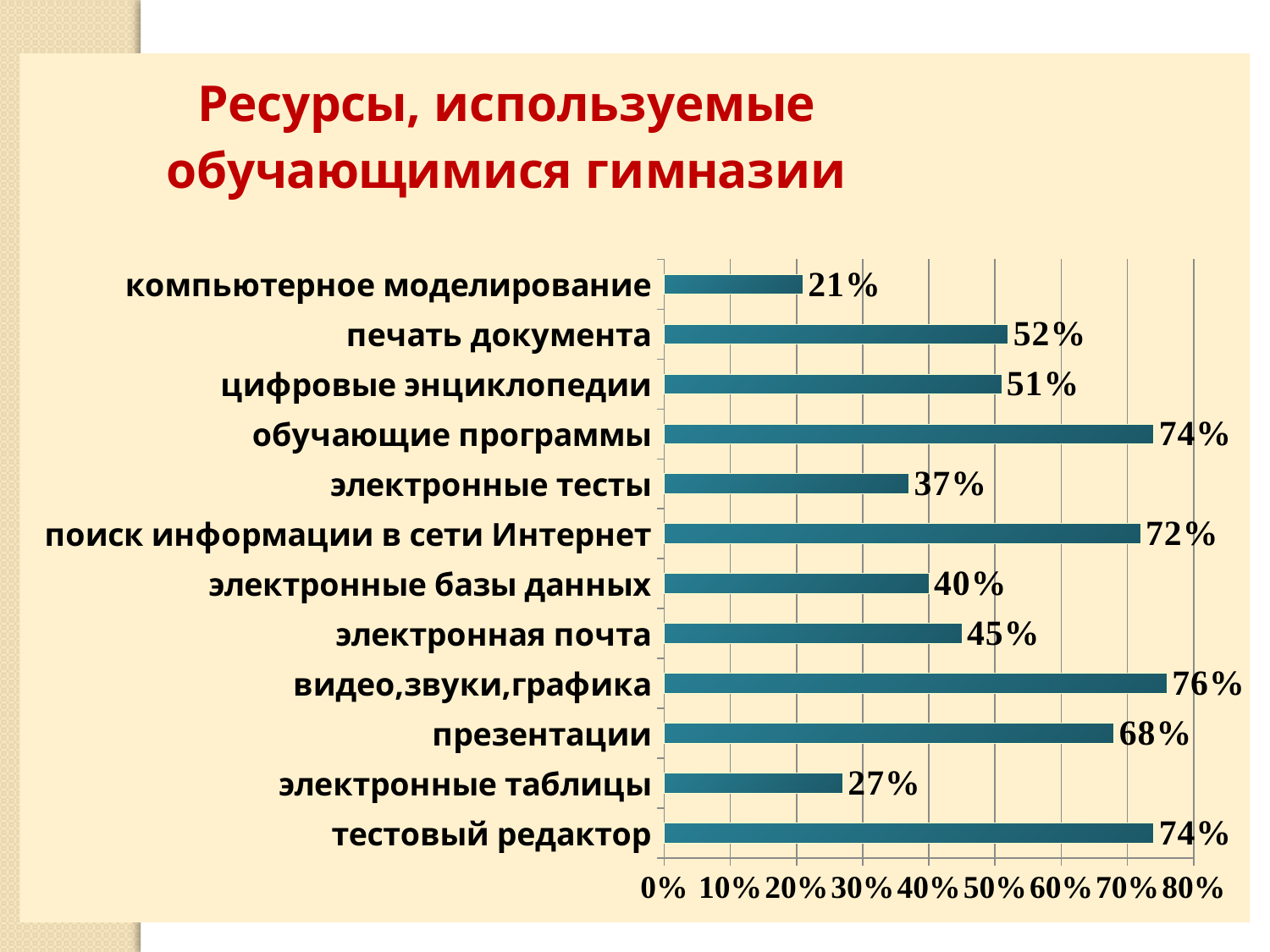
Is the value for печать документа greater or less than 40%? greater Which category has the lowest value? компьютерное моделирование What is the difference between the values for презентации and электронные таблицы? 41% What is the title of the slide? Ресурсы, используемые обучающимися гимназии What is the value for электронные тесты? 37% Which category has the highest value? видео,звуки,графика How many categories are shown in the chart? 12 What is the value for поиск информации в сети Интернет? 72% What is the value for видео,звуки,графика? 76% What is the difference between the values for обучающие программы and цифровые энциклопедии? 23% What kind of chart is shown on the slide? bar chart Which is larger, the value for электронная почта or the value for электронные базы данных? электронная почта